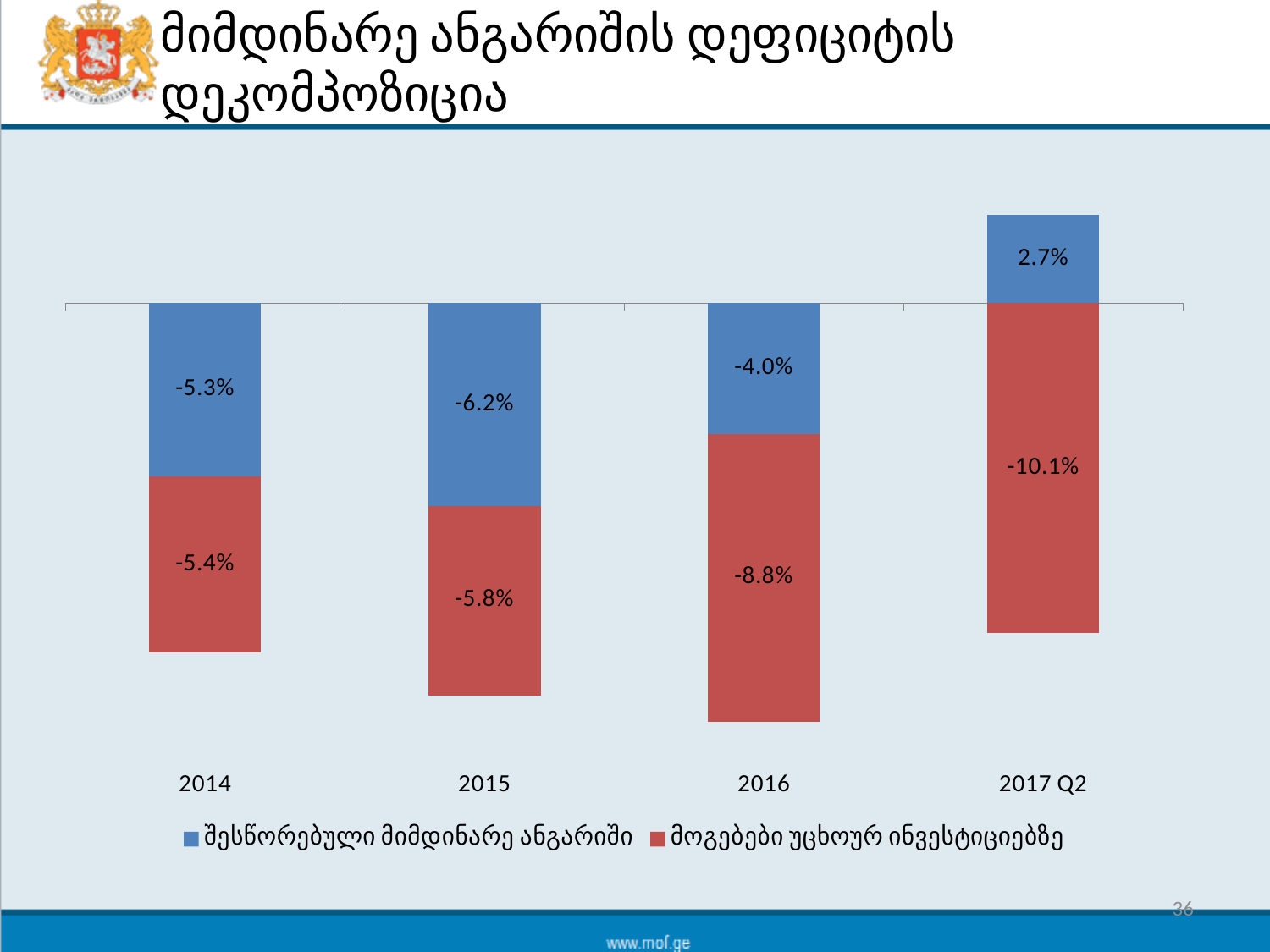
What is the value of the blue series (შესწორებული მიმდინარე ანგარიში) for 2017 Q2? 2.7% How many series does the legend list? 2 Which is larger, the blue series value for 2016 or for 2015? 2016 What is the total of the stacked bar for 2015? -12.0% What is the value of the red series (მოგებები უცხოურ ინვესტიციებზე) for 2016? -8.8% What kind of chart is shown on the slide? Stacked bar chart What is the value of the red series (მოგებები უცხოურ ინვესტიციებზე) for 2015? -5.8% What is the value of the blue series (შესწორებული მიმდინარე ანგარიში) for 2014? -5.3% How many periods are shown on the x axis? 4 In which period is the blue series (შესწორებული მიმდინარე ანგარიში) highest? 2017 Q2 In which period is the red series (მოგებები უცხოურ ინვესტიციებზე) lowest? 2017 Q2 What is the difference between the red series values for 2016 and 2014? 3.4 percentage points